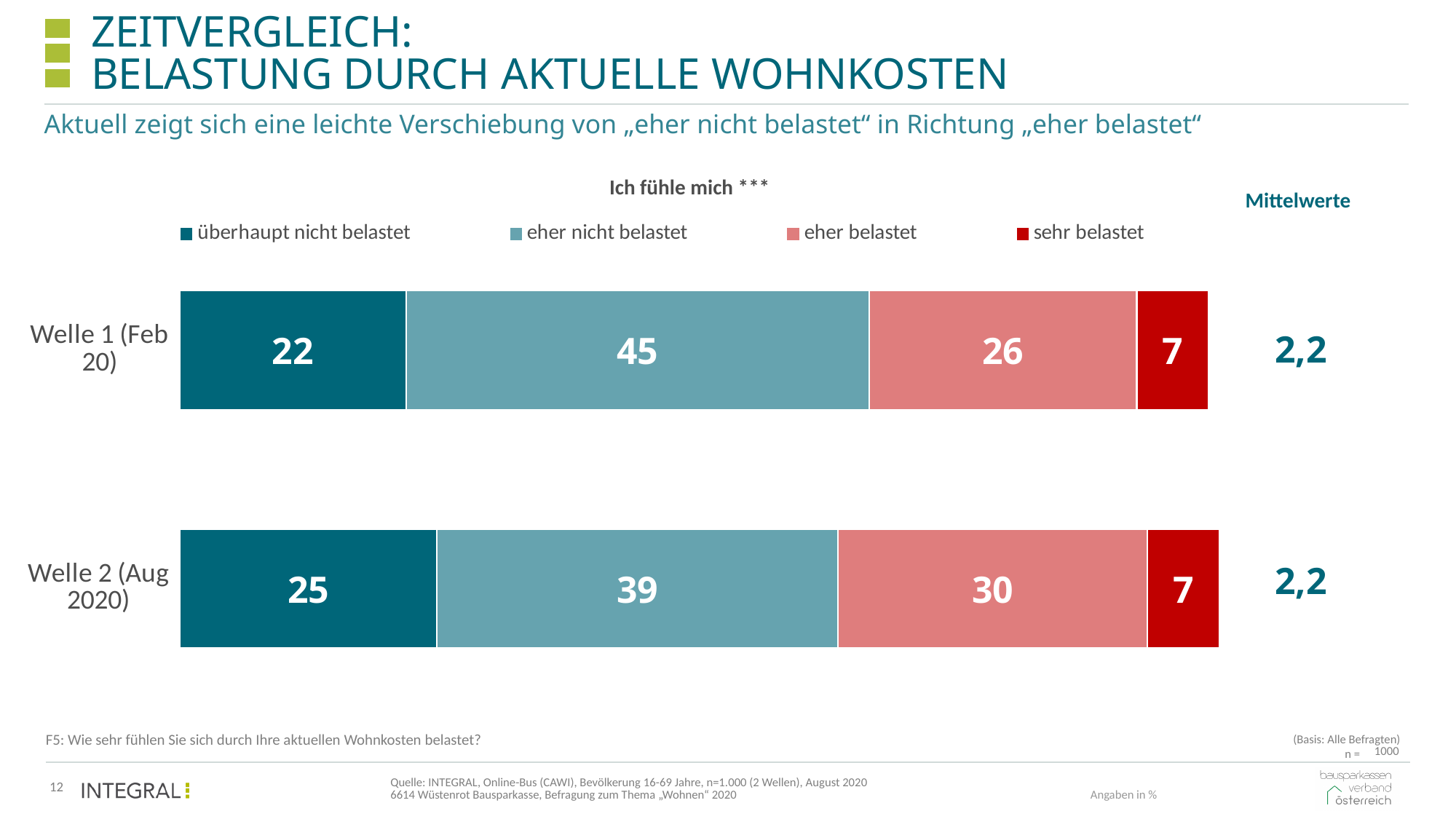
What is the Mittelwert shown for Welle 2 (Aug 2020)? 2,2 What is the difference between the "eher nicht belastet" values of Welle 1 (Feb 20) and Welle 2 (Aug 2020)? 6 What is the value for "eher nicht belastet" in Welle 1 (Feb 20)? 45 Which response category has the lowest value in Welle 1 (Feb 20)? sehr belastet How many bars (waves) are shown in the chart? 2 What kind of chart is shown on the slide? Stacked bar chart What is the value for "eher belastet" in Welle 2 (Aug 2020)? 30 Which response category has the highest value in Welle 2 (Aug 2020)? eher nicht belastet What is the value for "sehr belastet" in Welle 1 (Feb 20)? 7 How many series does the legend list? 4 What is the value for "überhaupt nicht belastet" in Welle 2 (Aug 2020)? 25 Is the value for "eher belastet" larger in Welle 1 (Feb 20) or in Welle 2 (Aug 2020)? Welle 2 (Aug 2020)